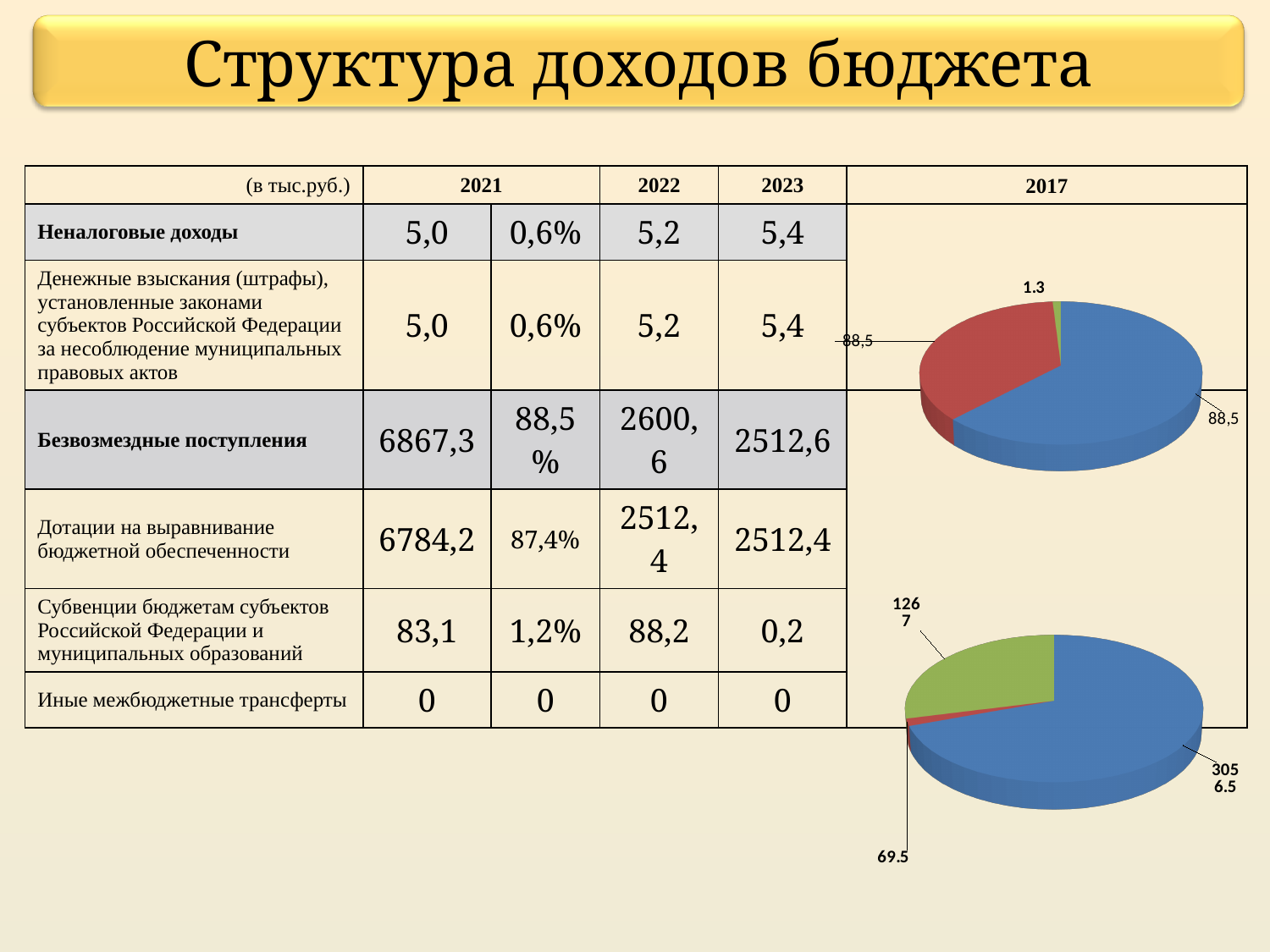
In the lower pie chart, which slice is larger, the green one or the red one? green Which colour is the largest slice in the upper pie chart? blue What kind of chart is the lower chart on the right side of the slide? pie chart How many slices does the upper pie chart have? 3 In the lower pie chart, what is the total of the three labelled values (3056.5, 1267 and 69.5)? 4393 In the lower pie chart, what value is labelled on the largest slice? 3056.5 What kind of chart is the upper chart on the right side of the slide? pie chart How many slices does the lower pie chart have? 3 In the lower pie chart, what value is labelled on the smallest slice? 69.5 In the lower pie chart, what value is labelled on the green slice? 1267 In the upper pie chart, what value is labelled on the smallest (green) slice? 1.3 In the lower pie chart, what is the difference between the largest slice value (3056.5) and the smallest slice value (69.5)? 2987